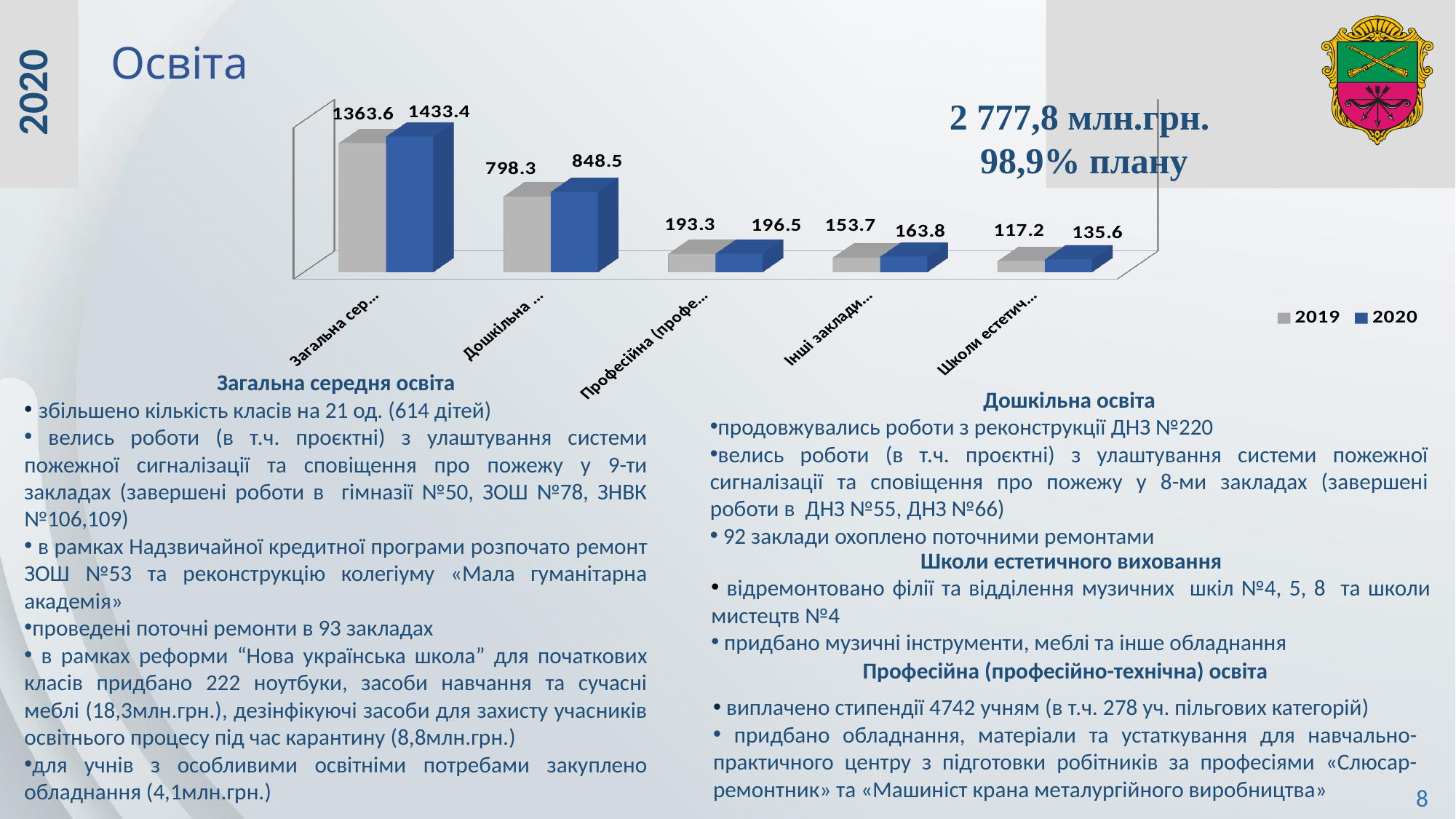
What is the 2020 value for the last category, "Школи естетич..."? 135.6 Which category has the highest 2020 value? Загальна сер... What is the 2020 value for the first category, "Загальна сер..."? 1433.4 How many series does the legend list? 2 What is the 2019 value for the category "Дошкільна ..."? 798.3 How many categories are shown on the chart? 5 By how much did the value for "Загальна сер..." increase from 2019 to 2020? 69.8 Which is larger in 2019: "Професійна (профе..." or "Інші заклади..."? Професійна (профе... What kind of chart is shown on the slide? Bar chart Which category has the lowest 2019 value? Школи естетич... What is the difference between the 2020 and 2019 values for "Дошкільна ..."? 50.2 Which is larger in 2020: "Інші заклади..." or "Школи естетич..."? Інші заклади...